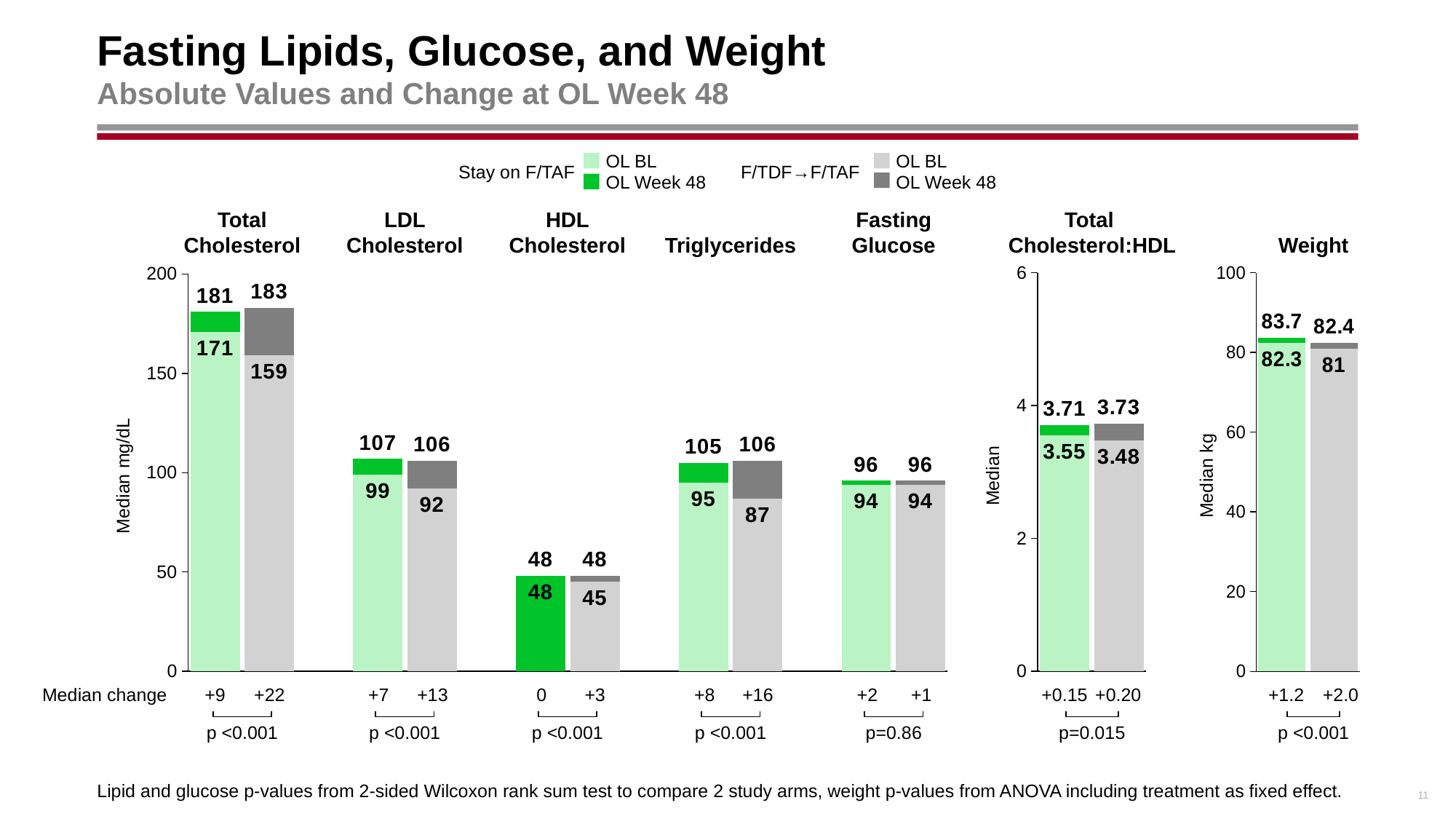
What kind of chart is used on this slide? Bar chart In the mg/dL chart, which parameter has the highest OL Week 48 value? Total Cholesterol In the mg/dL chart, what is the difference between the OL BL Total Cholesterol values of the Stay on F/TAF arm (171) and the F/TDF→F/TAF arm (159)? 12 In the Total Cholesterol:HDL chart, what is the OL BL value for the Stay on F/TAF arm? 3.55 What is the y-axis label of the Weight chart? Median kg In the mg/dL chart, which arm has the higher OL BL HDL Cholesterol value, Stay on F/TAF or F/TDF→F/TAF? Stay on F/TAF In the mg/dL chart, what is the median change in Triglycerides for the F/TDF→F/TAF arm? +16 In the mg/dL chart, which parameter has the lowest OL BL value? HDL Cholesterol In the Weight chart, what is the OL Week 48 value for the F/TDF→F/TAF arm? 82.4 In the mg/dL chart, what is the OL Week 48 Total Cholesterol value for the Stay on F/TAF arm? 181 How many entries does the legend list? 4 In the mg/dL chart, what is the OL BL LDL Cholesterol value for the F/TDF→F/TAF arm? 92